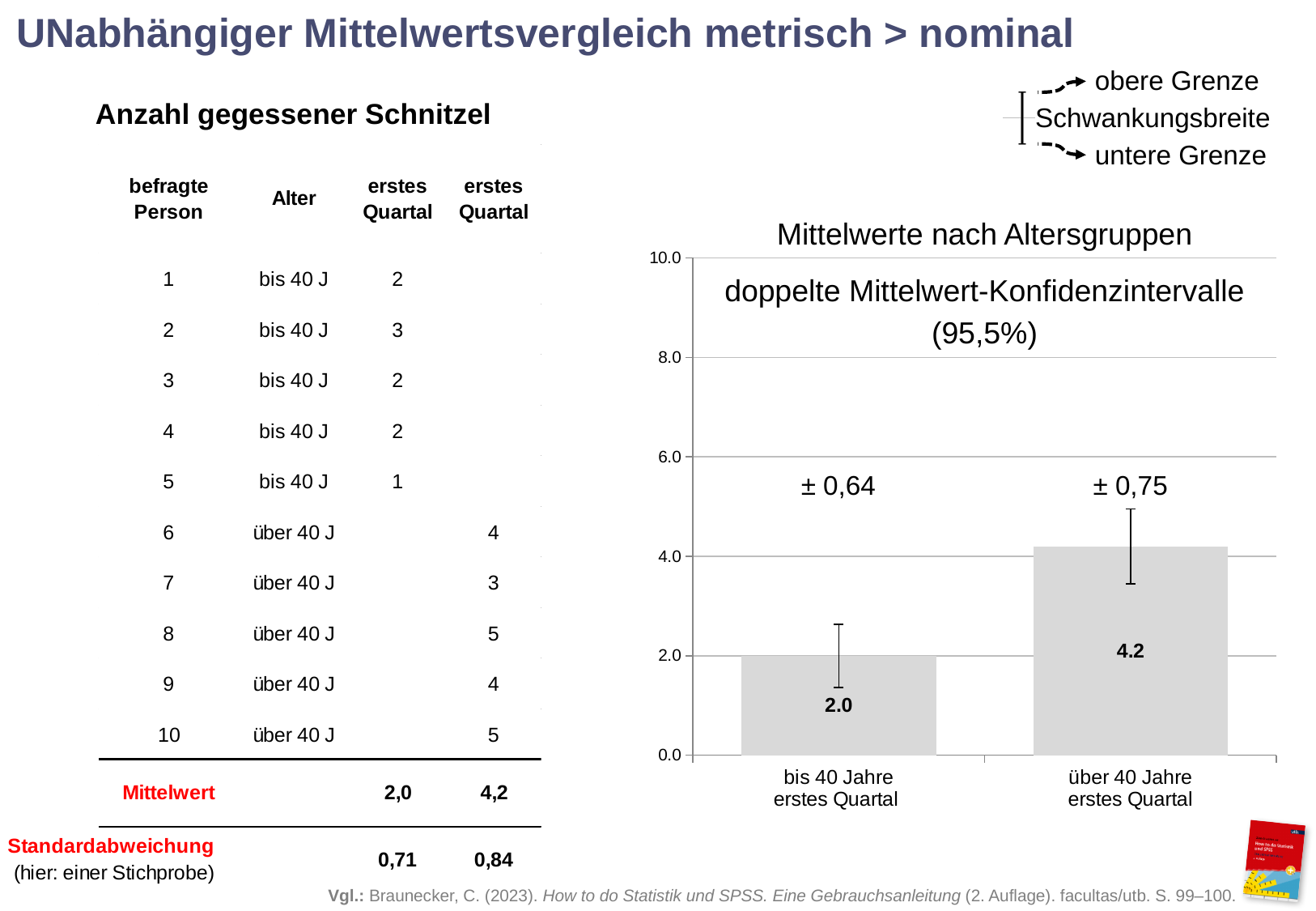
What is the difference between the bar values for 'über 40 Jahre' and 'bis 40 Jahre'? 2.2 Is the bar for 'über 40 Jahre erstes Quartal' greater or less than 4.0? greater What is the value of the bar for 'bis 40 Jahre erstes Quartal' in the chart? 2.0 What is the value of the bar for 'über 40 Jahre erstes Quartal' in the chart? 4.2 What is the title of the chart? Mittelwerte nach Altersgruppen Which age group has the lower mean value in the chart? bis 40 Jahre erstes Quartal How many bars are shown in the chart? 2 What is the confidence interval half-width shown above the 'über 40 Jahre' bar? ± 0,75 What type of chart is shown on the slide? bar chart Which age group has the higher mean value in the chart? über 40 Jahre erstes Quartal Is the bar for 'bis 40 Jahre erstes Quartal' greater or less than 4.0? less What is the confidence interval half-width shown above the 'bis 40 Jahre' bar? ± 0,64